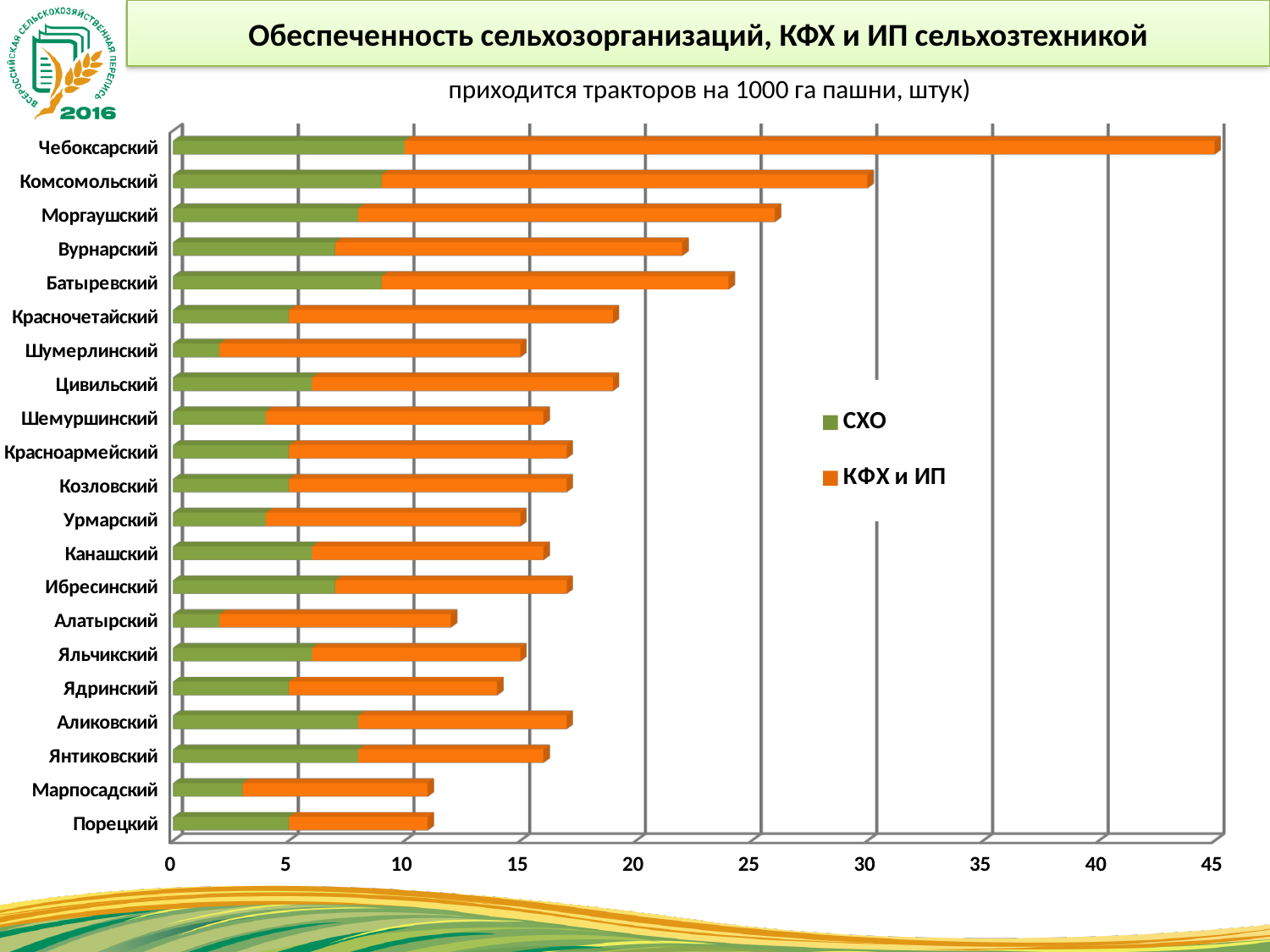
What are the two series named in the legend? СХО and КФХ и ИП How many series does the legend list? 2 What colour represents the КФХ и ИП series? orange Is the total value for Моргаушский greater or less than 25? greater Which district has the highest total bar? Чебоксарский Which has the larger total bar, Чебоксарский or Комсомольский? Чебоксарский Is the total value for Вурнарский greater or less than 20? greater What kind of chart is shown on the slide? bar chart Which has the larger СХО value, Чебоксарский or Шумерлинский? Чебоксарский How many districts (categories) are plotted on the chart? 21 Is the total value for Чебоксарский greater or less than 40? greater